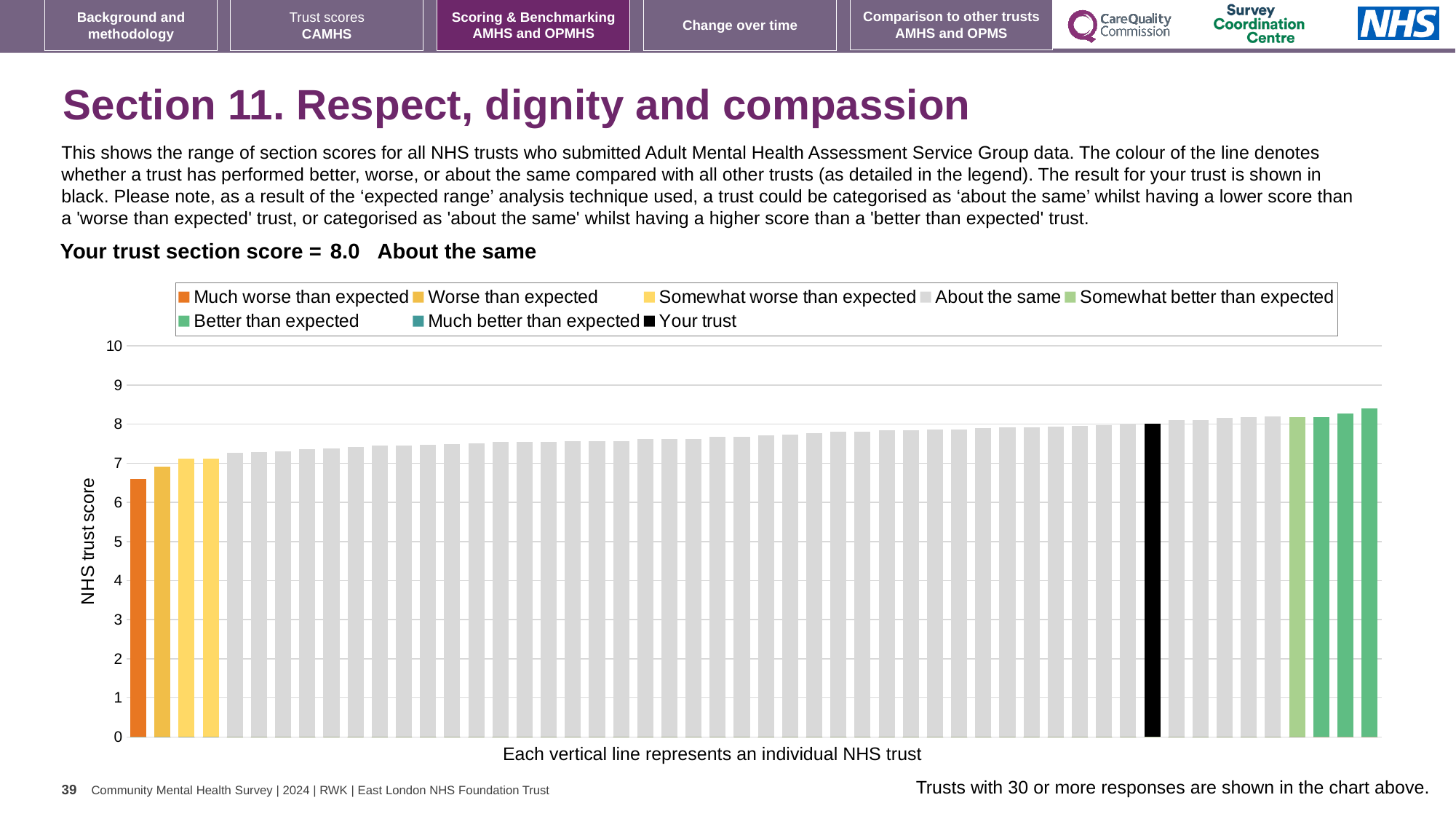
Which legend category does the lowest bar on the chart belong to? Much worse than expected Is the value of the black 'Your trust' bar greater or less than 9? less What kind of chart is shown on the slide? bar chart Which legend category does the highest bar on the chart belong to? Better than expected Is the value of the lowest (orange) bar greater or less than 7? less Is the value of the black 'Your trust' bar greater or less than 7? greater What is the label on the vertical axis of the chart? NHS trust score How many entries does the chart legend list? 8 What is the section score for your trust shown on the slide? 8.0 Do the bar values rise or fall from left to right along the x axis? rise Is the black 'Your trust' bar higher or lower than the orange 'Much worse than expected' bar? higher